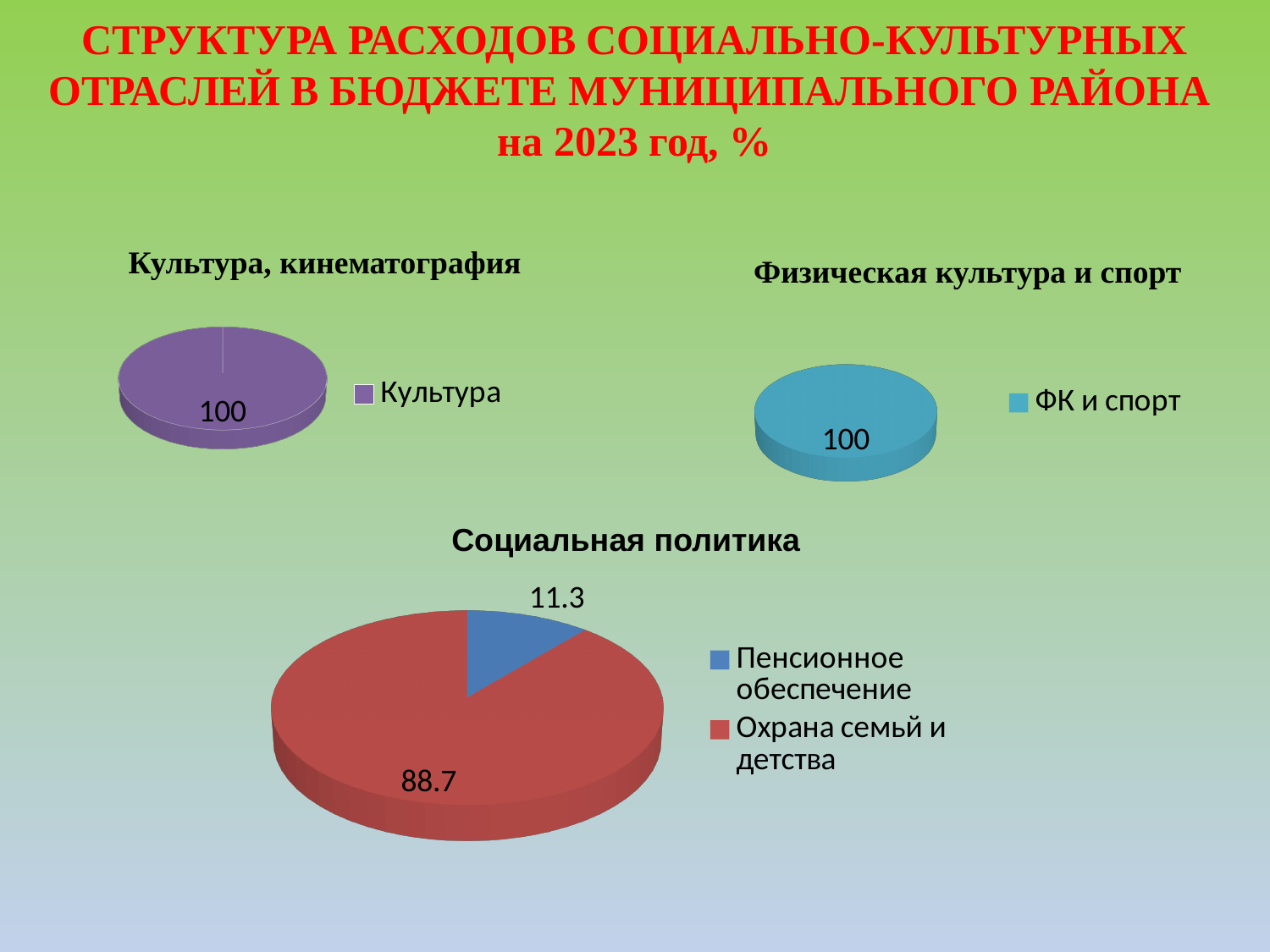
How many categories does the 'Социальная политика' chart show? 2 In the 'Социальная политика' chart, which category has the smallest slice? Пенсионное обеспечение What kind of chart is the 'Социальная политика' chart? Pie chart In the 'Социальная политика' chart, what is the value for 'Пенсионное обеспечение'? 11.3 How many pie charts are shown on the slide? 3 In the 'Социальная политика' chart, which is larger: 'Пенсионное обеспечение' or 'Охрана семьи и детства'? Охрана семьи и детства In the 'Физическая культура и спорт' chart, what is the value for 'ФК и спорт'? 100 In the 'Культура, кинематография' chart, what is the value for 'Культура'? 100 How many entries does the legend of the 'Физическая культура и спорт' chart list? 1 In the 'Социальная политика' chart, what is the difference between the values for 'Охрана семьи и детства' and 'Пенсионное обеспечение'? 77.4 In the 'Социальная политика' chart, what is the value for 'Охрана семьи и детства'? 88.7 In the 'Социальная политика' chart, which category has the largest slice? Охрана семьи и детства